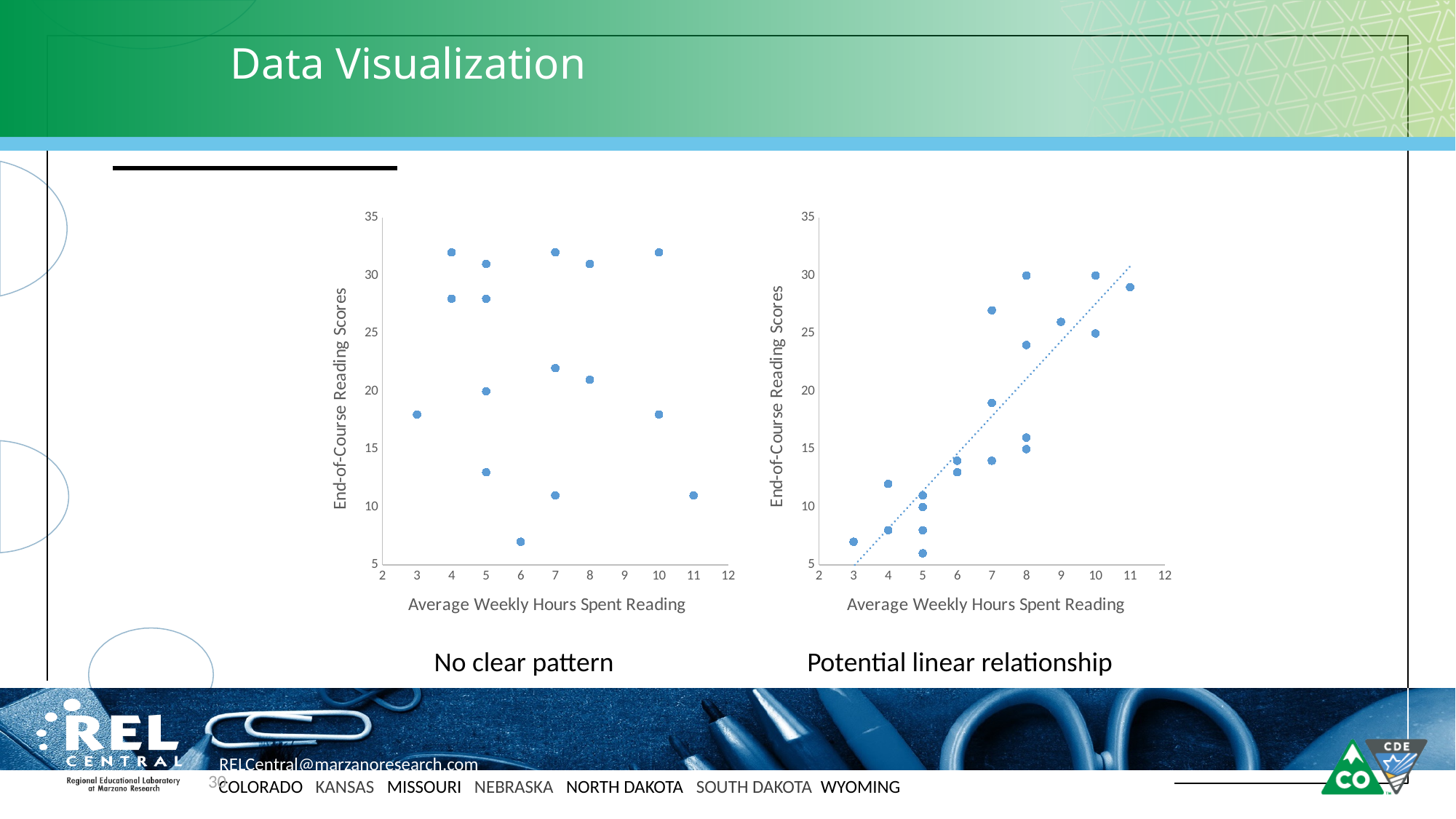
What is the y-axis title of the right chart? End-of-Course Reading Scores What is the x-axis title of the left chart? Average Weekly Hours Spent Reading In the left chart, is the value for the point at 11 hours greater or less than 15? less In the right chart, do the reading scores generally rise or fall as average weekly hours spent reading increases? Rise In the right chart, is the value for the point at 3 hours greater or less than 10? less In the right chart, is the value for the point at 11 hours greater or less than 25? greater Which chart on the slide includes a dotted trend line, the left or the right? The right chart What kind of chart is the left chart on the slide? Scatter chart What kind of chart is the right chart on the slide? Scatter chart